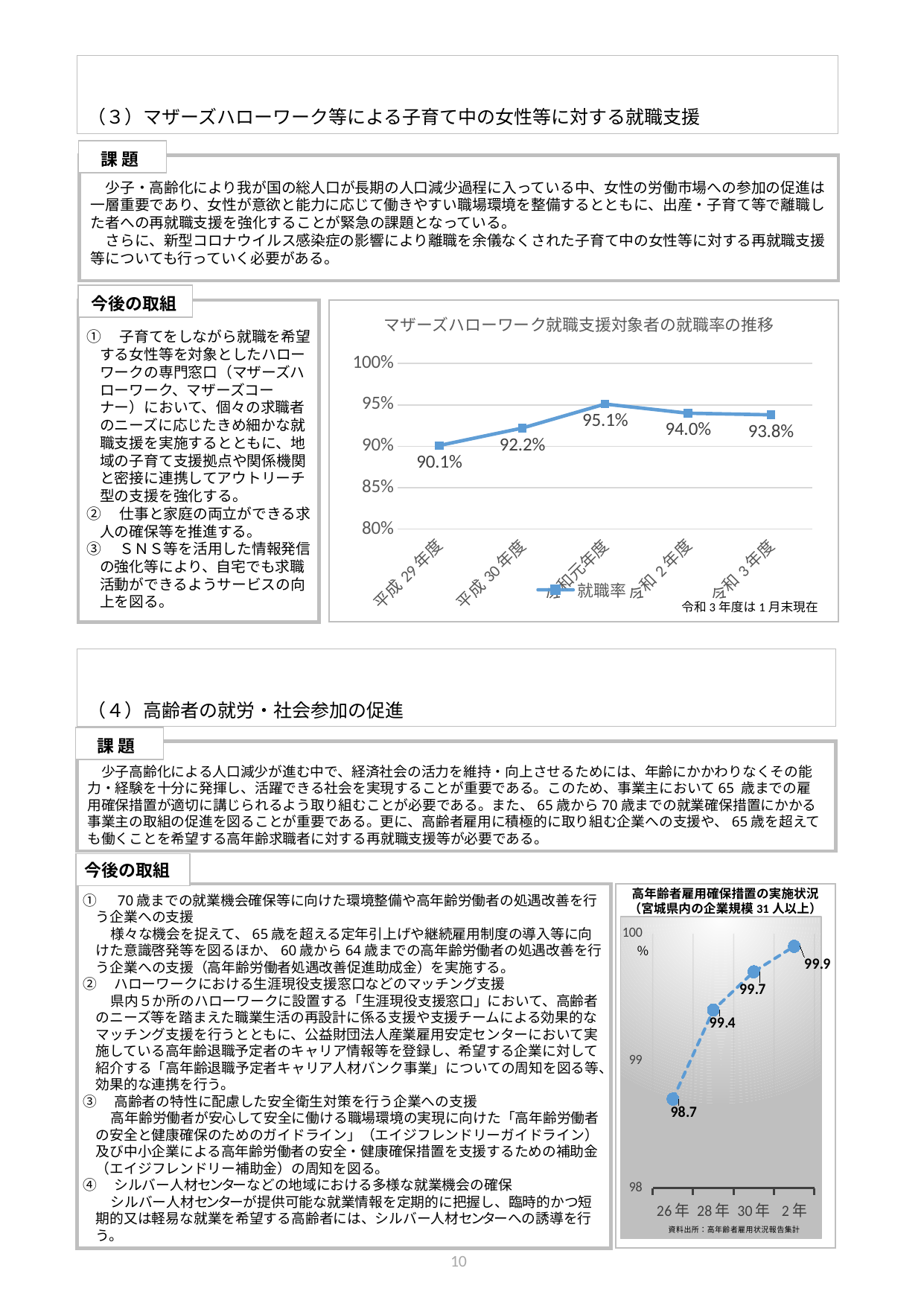
In the chart titled マザーズハローワーク就職支援対象者の就職率の推移, what kind of chart is it? Line chart In the chart titled マザーズハローワーク就職支援対象者の就職率の推移, what is the value for 令和元年度? 95.1% In the chart titled マザーズハローワーク就職支援対象者の就職率の推移, what is the value for 平成29年度? 90.1% In the chart titled マザーズハローワーク就職支援対象者の就職率の推移, which year has the lowest value? 平成29年度 In the chart titled マザーズハローワーク就職支援対象者の就職率の推移, how many data points are plotted? 5 In the chart titled 高年齢者雇用確保措置の実施状況, do the values rise or fall from 26年 to 2年? Rise In the chart titled マザーズハローワーク就職支援対象者の就職率の推移, what is the legend entry? 就職率 In the chart titled 高年齢者雇用確保措置の実施状況, what is the value for 26年? 98.7 In the chart titled マザーズハローワーク就職支援対象者の就職率の推移, what is the difference between the values for 令和元年度 and 平成29年度? 5.0% In the chart titled 高年齢者雇用確保措置の実施状況, what is the difference between the values for 28年 and 26年? 0.7 In the chart titled マザーズハローワーク就職支援対象者の就職率の推移, which year has the highest value? 令和元年度 In the chart titled 高年齢者雇用確保措置の実施状況, what is the value for 2年? 99.9